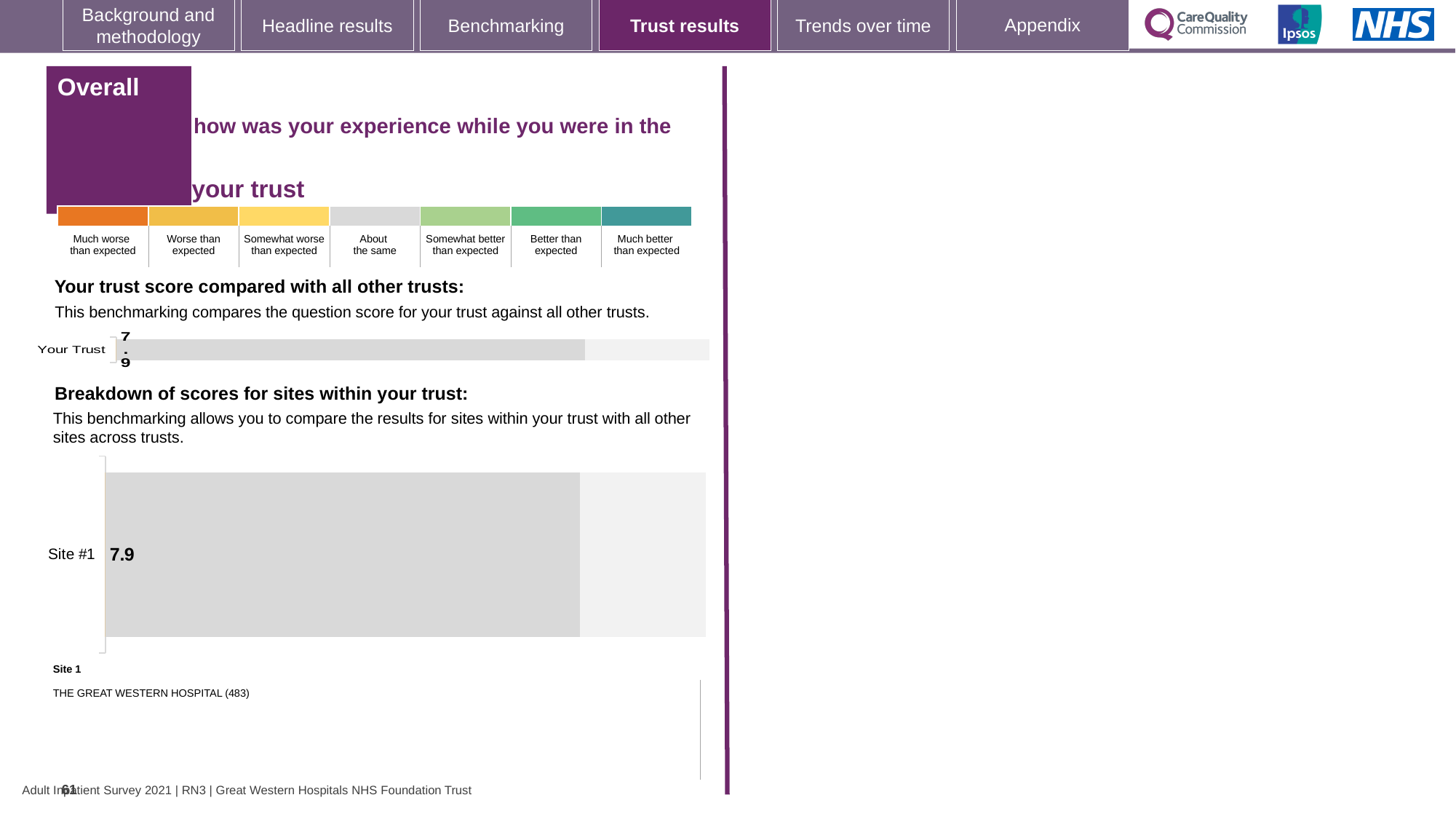
Which site name is listed under Site 1 below the 'Breakdown of scores for sites within your trust' chart? THE GREAT WESTERN HOSPITAL (483) What kind of chart is the 'Your trust score compared with all other trusts' chart? bar chart How many bars are plotted in the 'Breakdown of scores for sites within your trust' chart? 1 Is the value for Site #1 in the 'Breakdown of scores for sites within your trust' chart larger than, smaller than, or equal to the value for Your Trust in the 'Your trust score compared with all other trusts' chart? equal What kind of chart is the 'Breakdown of scores for sites within your trust' chart? bar chart In the 'Your trust score compared with all other trusts' chart, what is the value for Your Trust? 7.9 How many categories are shown in the 'Your trust score compared with all other trusts' chart? 1 What is the label of the only category in the 'Breakdown of scores for sites within your trust' chart? Site #1 In the 'Breakdown of scores for sites within your trust' chart, what is the value for Site #1? 7.9